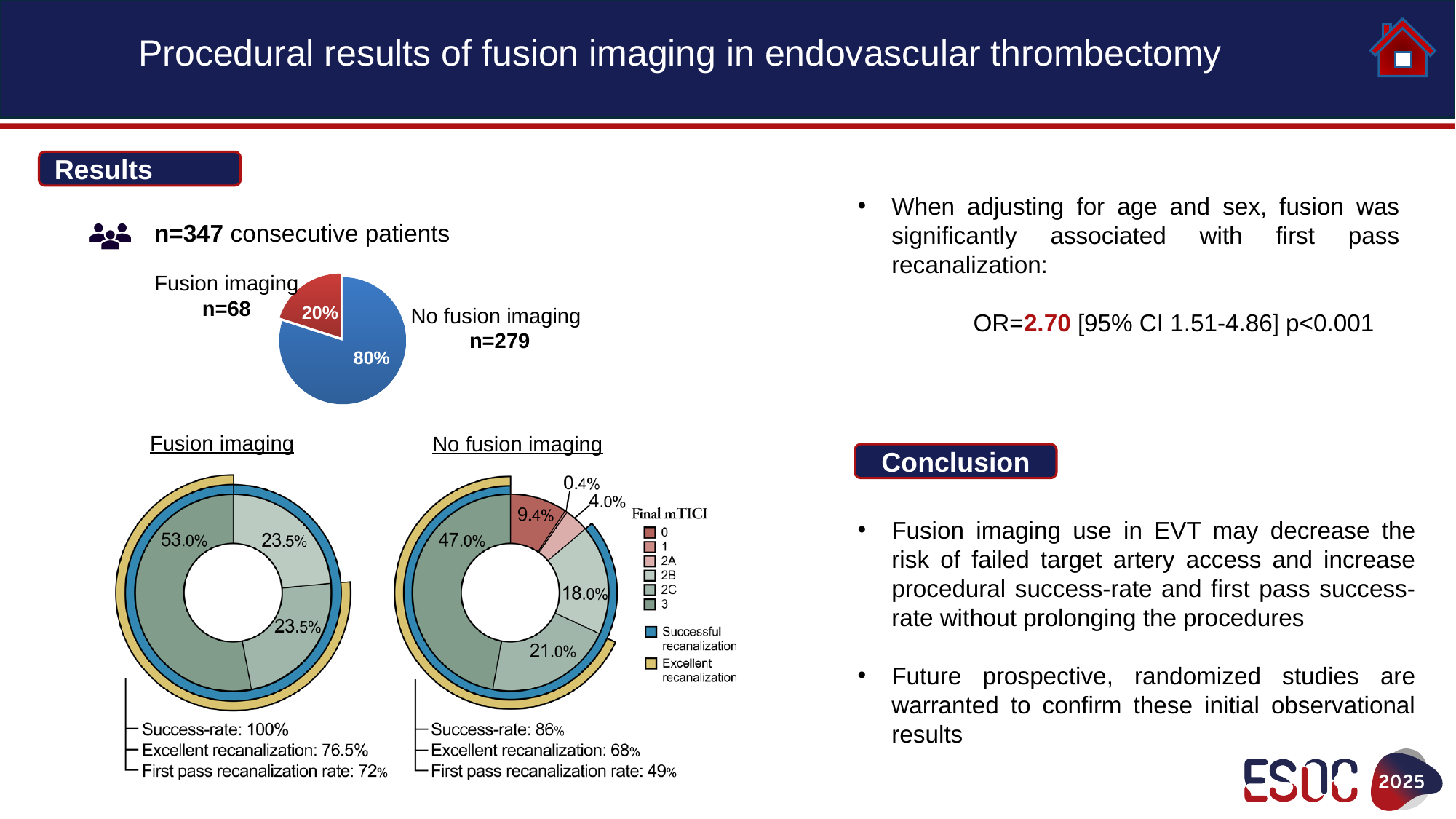
In the No fusion imaging donut chart, which final mTICI category has the largest share? 3 Which donut chart shows a larger share for final mTICI 2B, Fusion imaging or No fusion imaging? Fusion imaging How many final mTICI categories does the legend next to the donut charts list? 6 In the No fusion imaging donut chart, what share of patients had a final mTICI of 0? 9.4% What kind of chart shows the split between fusion imaging and no fusion imaging patients? pie chart In the pie chart of patients, how many patients are in the no fusion imaging group? n=279 What is the first pass recanalization rate reported below the No fusion imaging donut chart? 49% In the No fusion imaging donut chart, which final mTICI category has the smallest share? 1 In the pie chart of patients, what percentage of patients had fusion imaging? 20% In the Fusion imaging donut chart, what share of patients had a final mTICI of 3? 53.0% How many final mTICI segments are shown in the No fusion imaging donut chart? 6 How many percentage points higher is the mTICI 3 share in the Fusion imaging donut chart than in the No fusion imaging donut chart? 6.0 percentage points